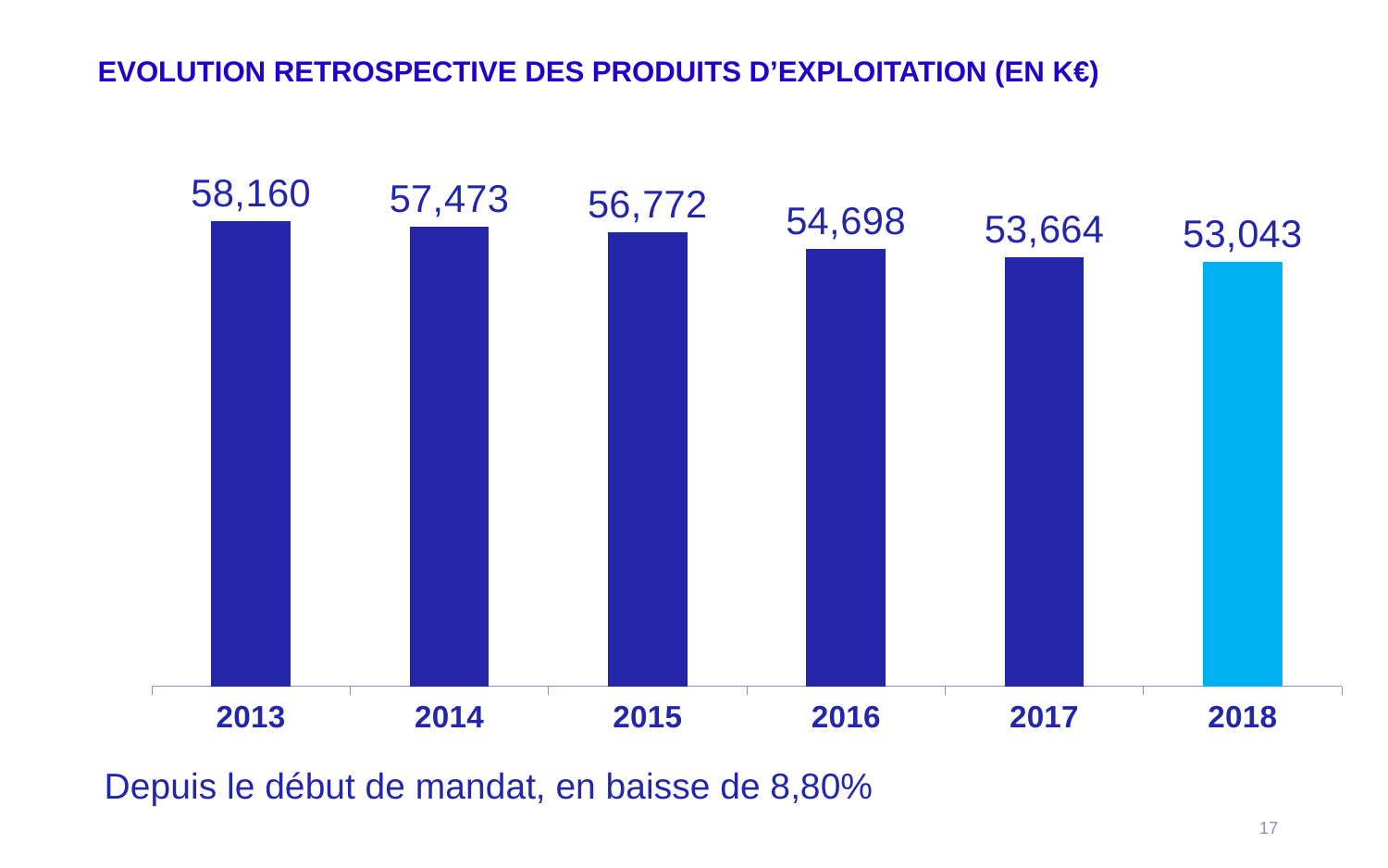
What is the value for 2013? 58,160 Which bar is shown in a different (light blue) colour from the others? 2018 Which is larger, the value for 2014 or the value for 2017? 2014 What kind of chart is shown on the slide? bar chart What is the value for 2016? 54,698 How many years are shown on the chart? 6 Which year has the lowest value? 2018 What is the difference between the values for 2015 and 2016? 2,074 Do the values rise or fall from 2013 to 2018? fall Which year has the highest value? 2013 What is the value for 2018? 53,043 What is the difference between the values for 2013 and 2018? 5,117